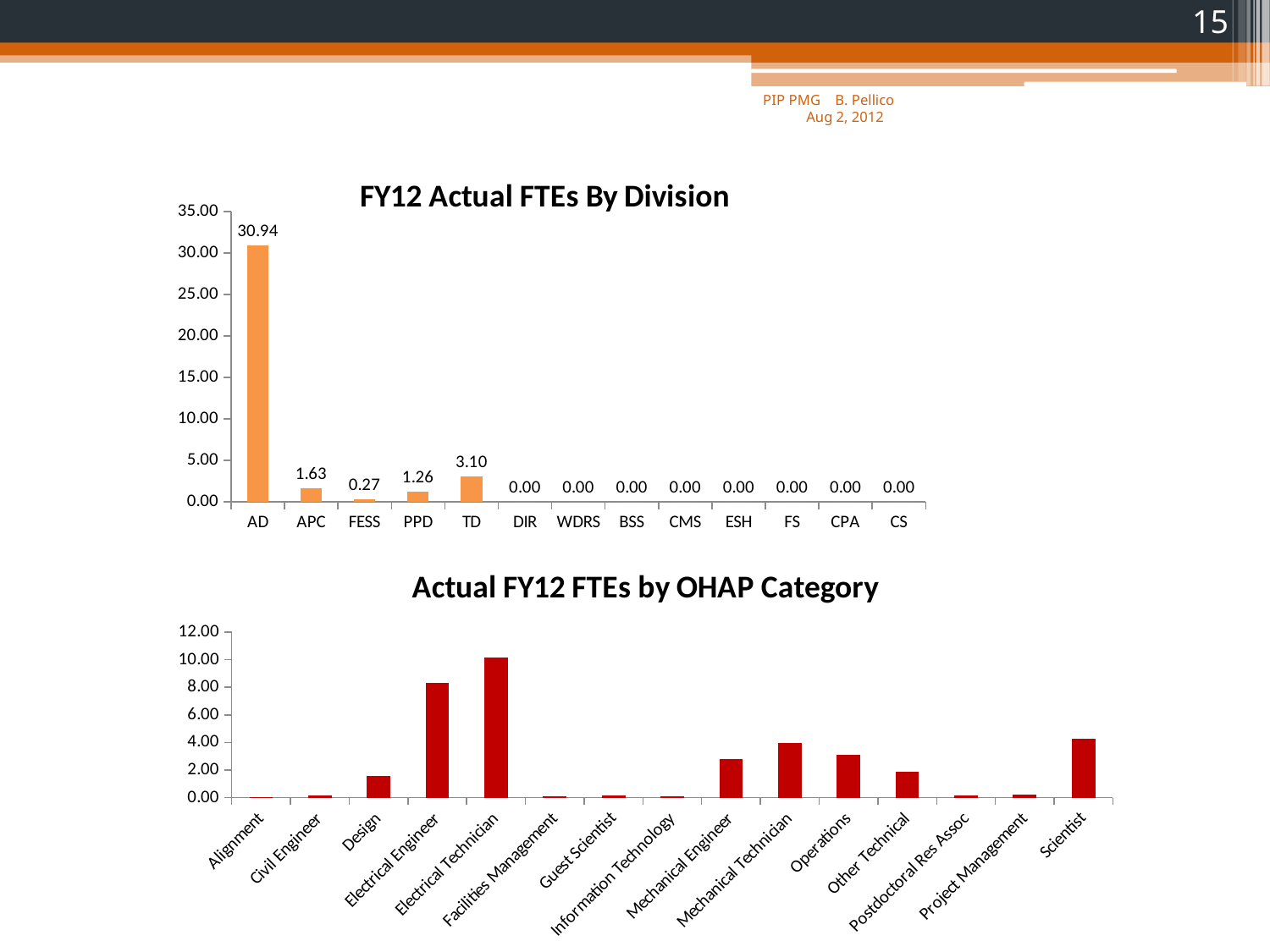
In the 'FY12 Actual FTEs By Division' chart, what is the difference between the values for APC and PPD? 0.37 In the 'FY12 Actual FTEs By Division' chart, which division has the highest value? AD In the 'Actual FY12 FTEs by OHAP Category' chart, is the value for Electrical Engineer greater or less than 6.00? greater In the 'FY12 Actual FTEs By Division' chart, what is the value for TD? 3.10 In the 'FY12 Actual FTEs By Division' chart, how many divisions have a value of 0.00? 8 What kind of chart is 'Actual FY12 FTEs by OHAP Category'? bar chart How many categories are shown on the x axis of the 'Actual FY12 FTEs by OHAP Category' chart? 15 In the 'FY12 Actual FTEs By Division' chart, what is the value for FESS? 0.27 In the 'Actual FY12 FTEs by OHAP Category' chart, which category has the highest value? Electrical Technician In the 'FY12 Actual FTEs By Division' chart, which is larger, the value for TD or the value for APC? TD In the 'FY12 Actual FTEs By Division' chart, what is the value for AD? 30.94 How many divisions are shown on the x axis of the 'FY12 Actual FTEs By Division' chart? 13